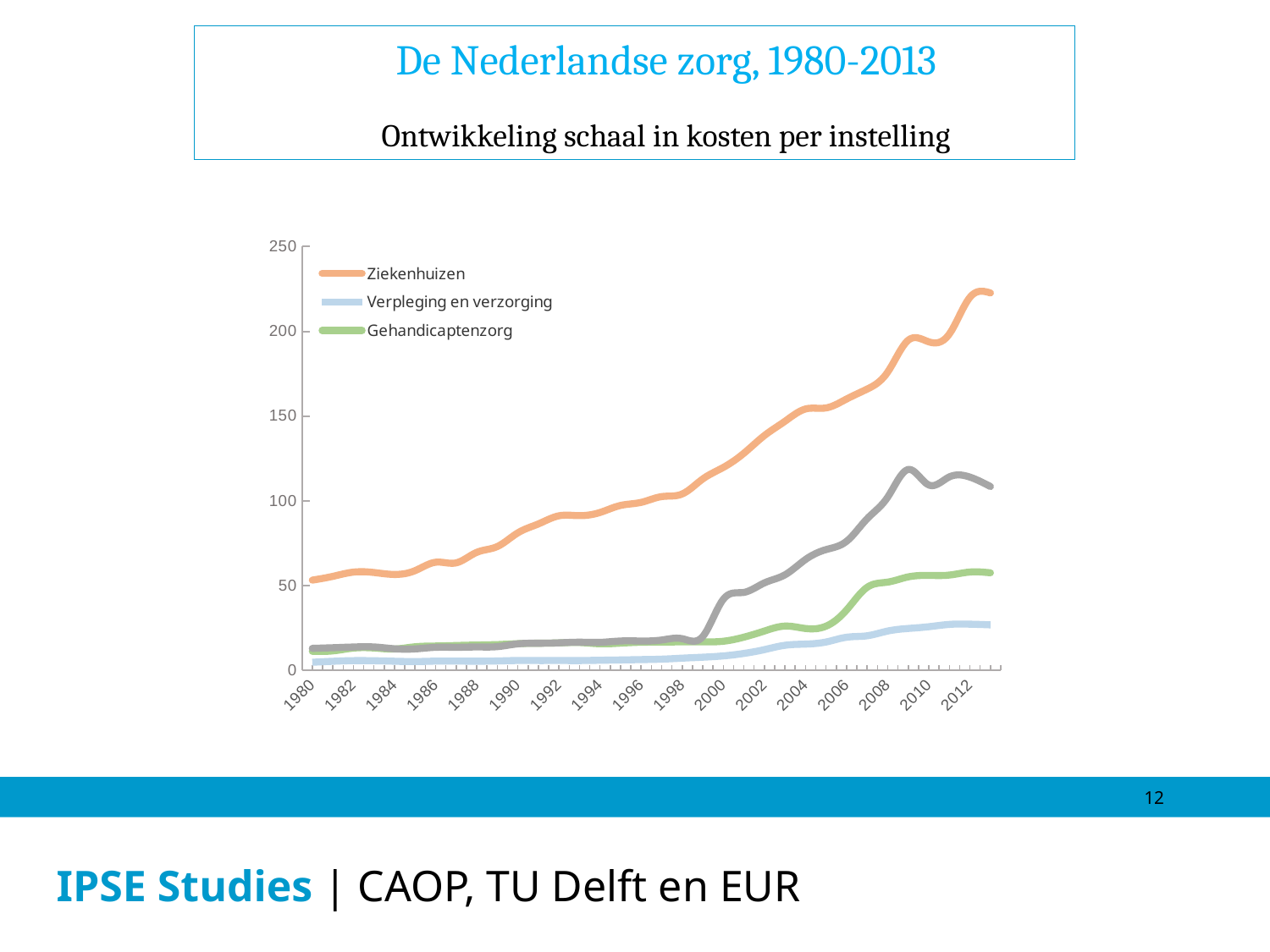
How many year labels are shown on the x axis? 17 Which series has the highest value in 2012? Ziekenhuizen What is the subtitle of the chart shown on the slide? Ontwikkeling schaal in kosten per instelling How many series does the legend list? 3 Does the Ziekenhuizen line rise or fall overall from 1980 to 2012? rise Is the value for Gehandicaptenzorg in 2012 greater or less than 50? greater What kind of chart is shown on the slide? line chart Which series has the lowest value in 2012? Verpleging en verzorging Is the value for Ziekenhuizen in 1980 greater or less than 100? less Is the value for Ziekenhuizen in 2012 greater or less than 200? greater In 2010, which is larger: Gehandicaptenzorg or Verpleging en verzorging? Gehandicaptenzorg